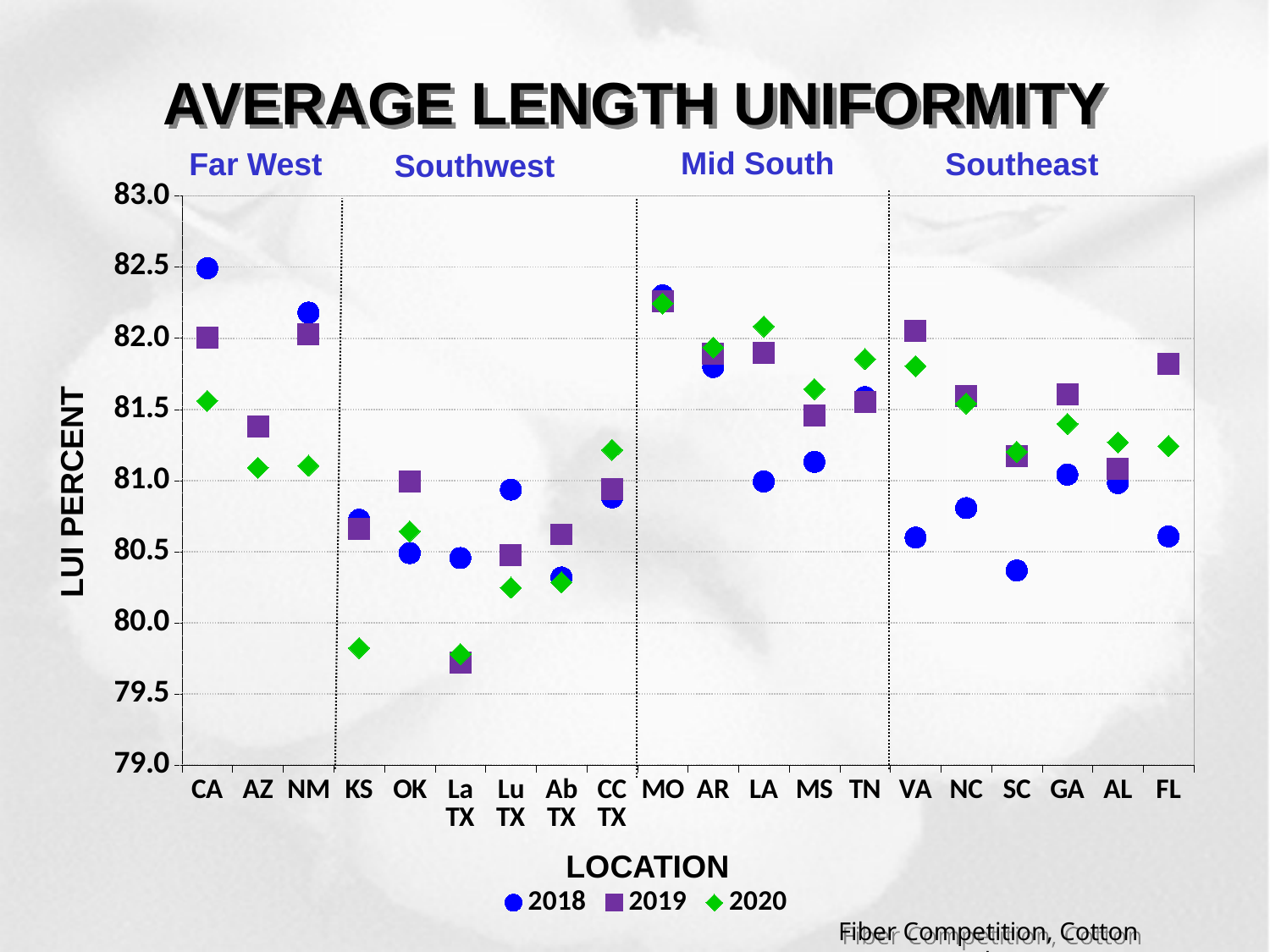
Is the 2018 value for CA greater or less than 82.0? greater What is the title of the y axis? LUI PERCENT How many locations are plotted along the x axis? 20 Which is larger: the 2020 value for MO or the 2020 value for KS? MO Is the 2019 value for La TX greater or less than 80.0? less Which is larger for VA: the 2018 value or the 2019 value? 2019 Is the 2018 value for SC greater or less than 80.5? less Which location has the highest 2018 value? CA What kind of chart is shown on the slide? Scatter (dot) chart Which location has the lowest 2019 value? La TX How many series does the legend list? 3